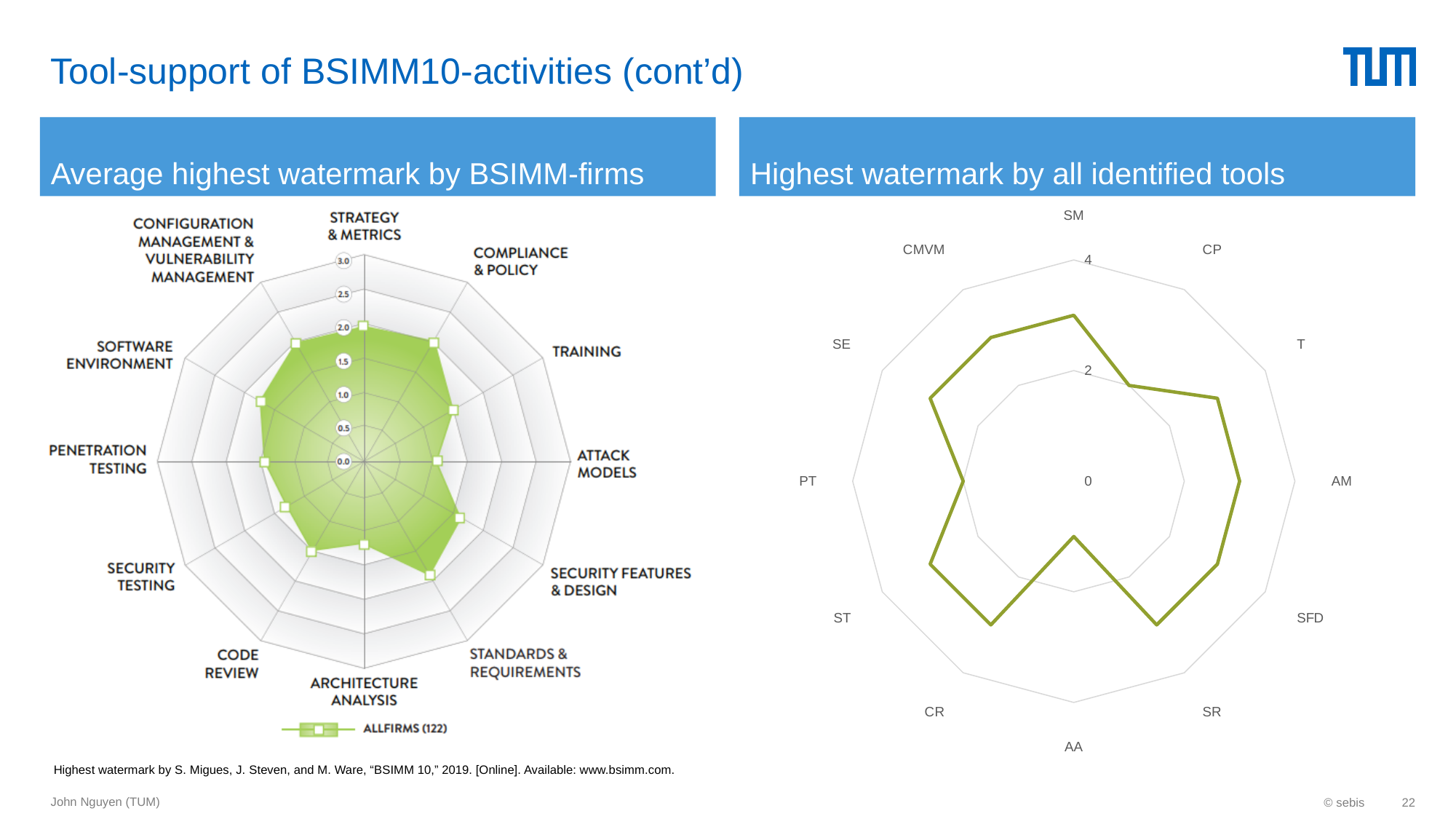
On the 'Average highest watermark by BSIMM-firms' chart, which is larger, the value for Strategy & Metrics or the value for Attack Models? Strategy & Metrics What is the legend entry on the 'Average highest watermark by BSIMM-firms' chart? ALLFIRMS (122) What kind of chart is the 'Highest watermark by all identified tools' chart on the right? Radar chart How many categories are plotted on the 'Highest watermark by all identified tools' chart? 12 On the 'Highest watermark by all identified tools' chart, which category has the lowest value? AA On the 'Highest watermark by all identified tools' chart, is the value for AM greater or less than 4? less On the 'Highest watermark by all identified tools' chart, which is larger, the value for SE or the value for AA? SE How many series does the legend of the 'Average highest watermark by BSIMM-firms' chart list? 1 On the 'Average highest watermark by BSIMM-firms' chart, is the value for Attack Models greater or less than 1.5? less On the 'Highest watermark by all identified tools' chart, is the value for SM greater or less than 2? greater How many categories are plotted on the 'Average highest watermark by BSIMM-firms' chart on the left? 12